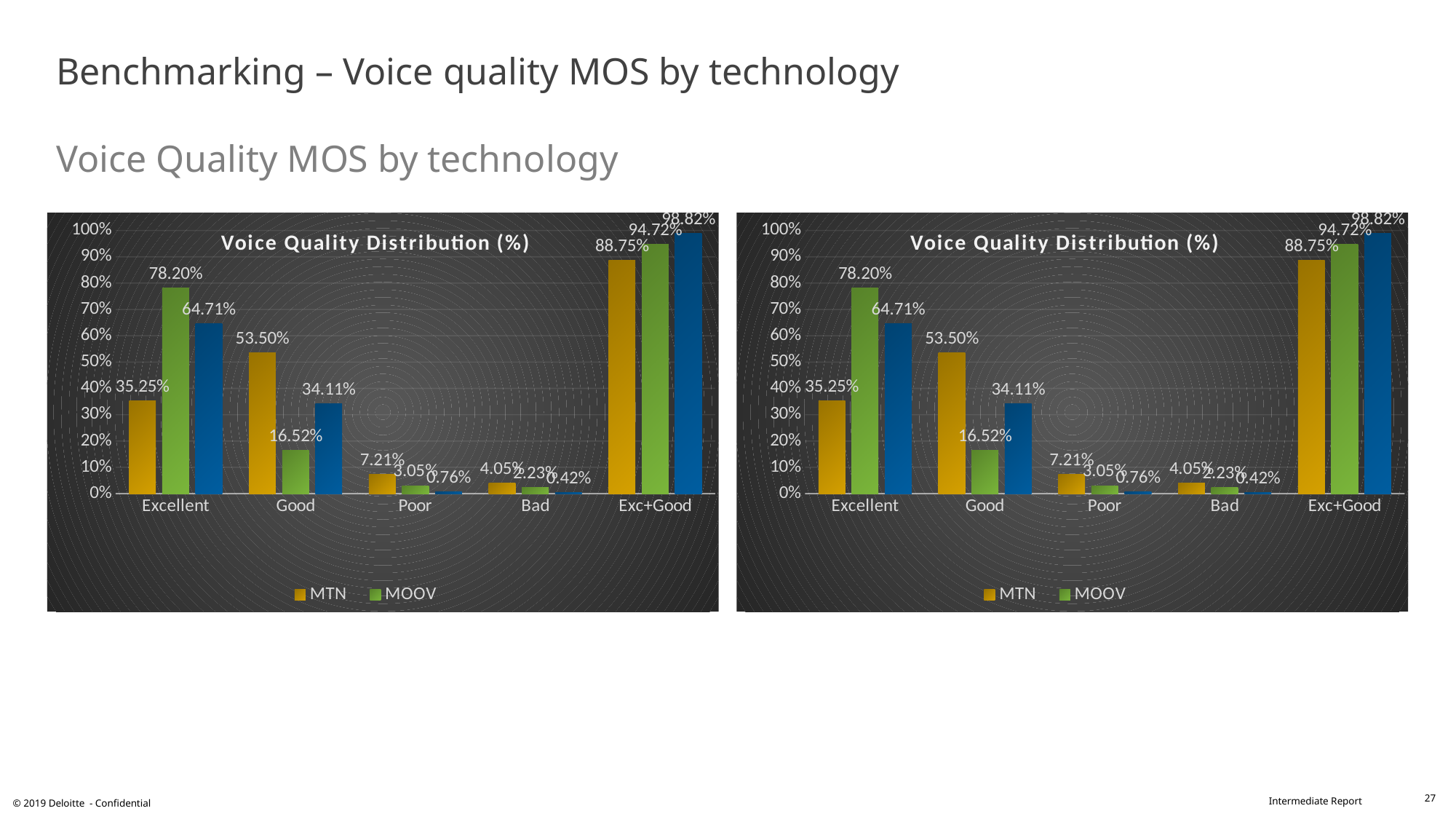
On the right chart, what is the MOOV value for Poor? 3.05% On the left chart, how many categories are shown on the x axis? 5 On the left chart, which category has the lowest MOOV value? Bad On the left chart, which is larger for Good: MTN or MOOV? MTN What kind of chart is the left chart? Bar chart On the left chart, which category has the highest MTN value? Exc+Good On the left chart, what is the MTN value for Excellent? 35.25% On the right chart, what is the MTN value for Exc+Good? 88.75% On the right chart, how many series does the legend list? 2 On the right chart, is the MTN value for Good greater or less than 50%? greater On the right chart, what is the difference between the MOOV and MTN values for Excellent? 42.95% On the left chart, what is the MOOV value for Good? 16.52%